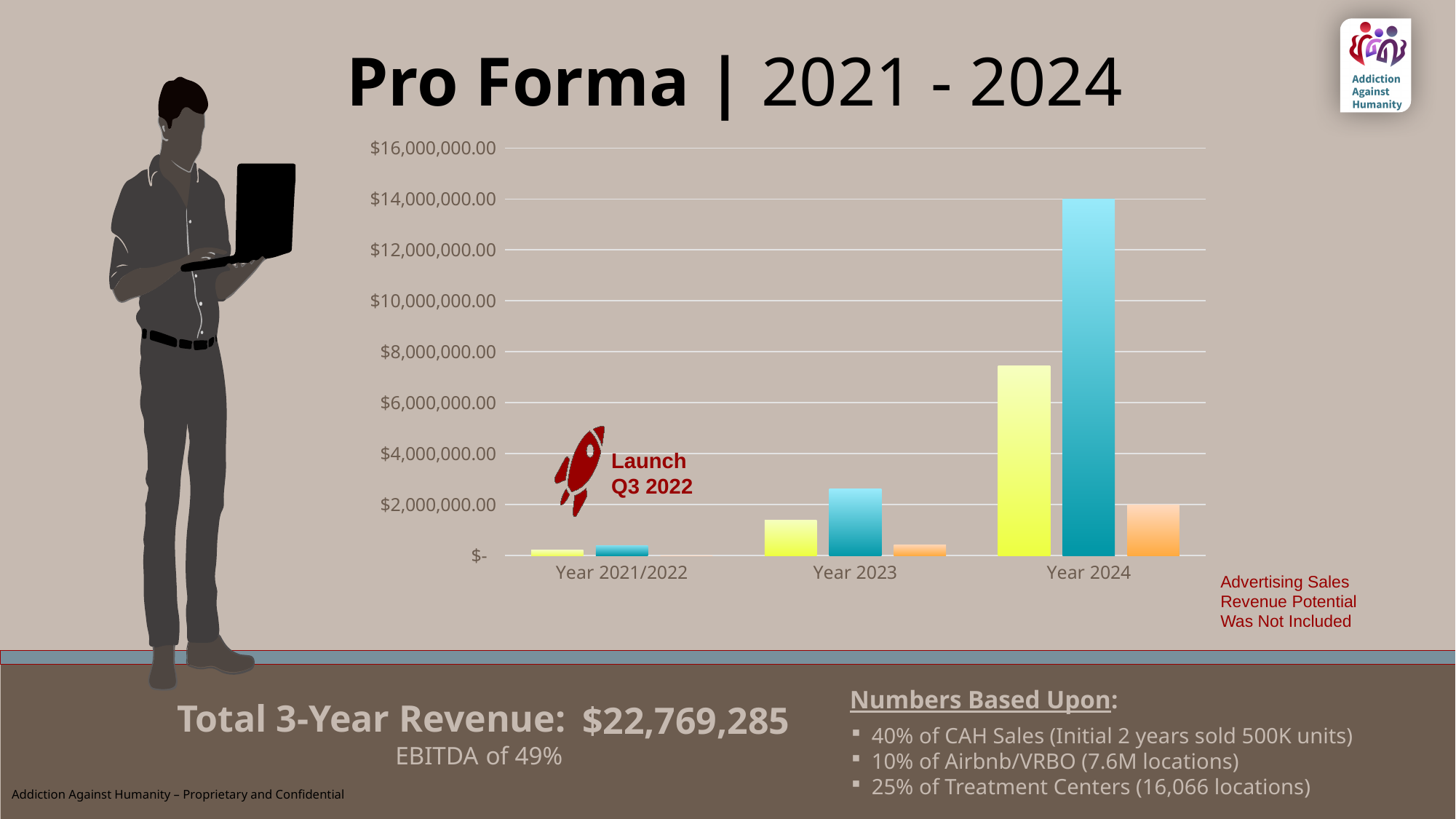
What is the title of the slide containing the chart? Pro Forma | 2021 - 2024 What launch timing is annotated next to the rocket icon on the chart? Launch Q3 2022 Is the value of the yellow bar for Year 2023 greater or less than $2,000,000.00? less Is the value of the teal (middle) bar for Year 2024 greater or less than $12,000,000.00? greater How many year categories are shown on the x axis of the chart? 3 Which year category has the tallest bar in the chart? Year 2024 Do the bar values rise or fall from Year 2021/2022 to Year 2024? Rise Is the value of the yellow bar for Year 2024 greater or less than $8,000,000.00? less What kind of chart is shown on the slide? Bar chart For Year 2024, which is larger: the yellow bar or the teal (middle) bar? The teal (middle) bar Which year category has the shortest bars in the chart? Year 2021/2022